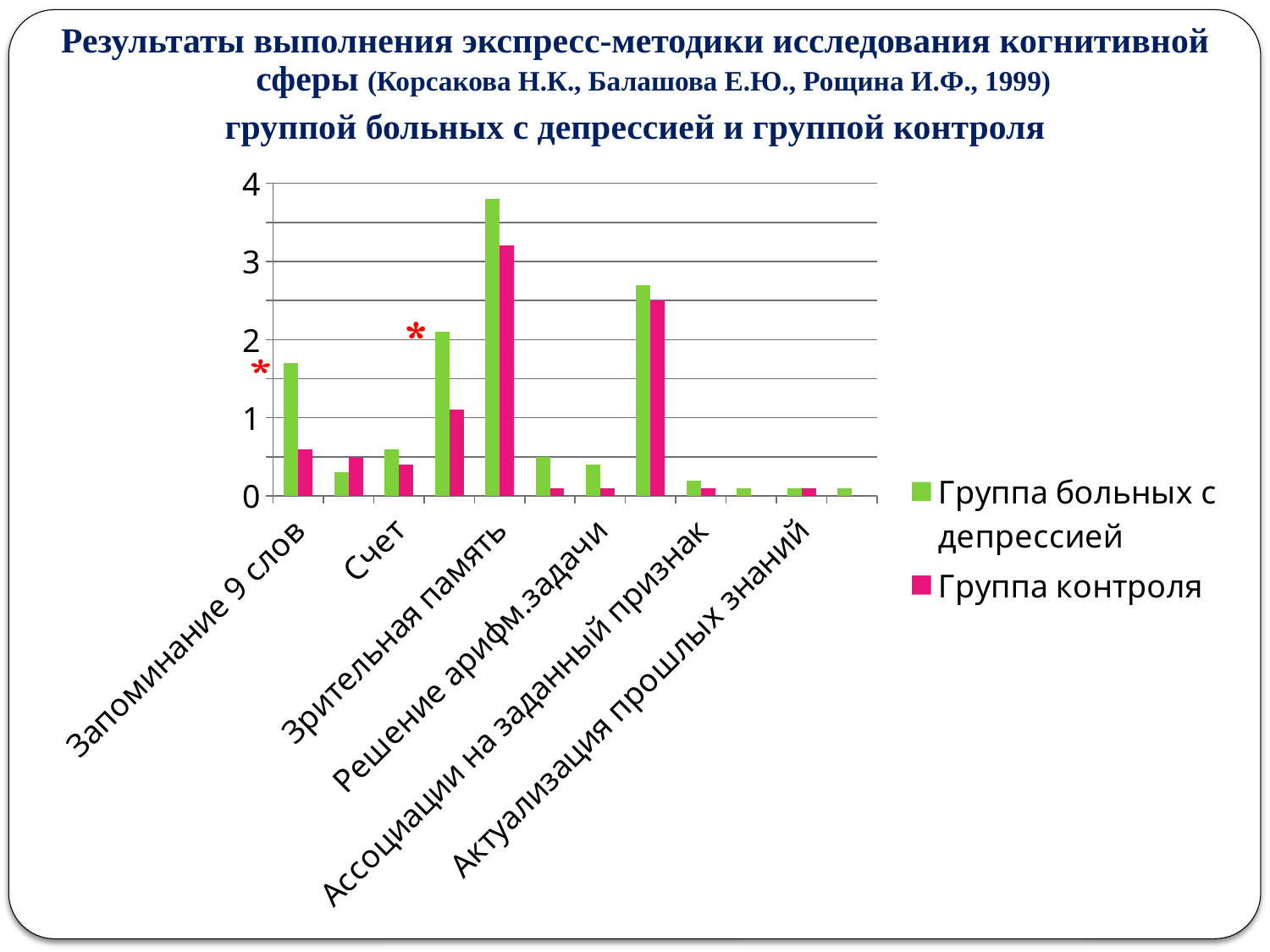
Is the value for Группа контроля on Запоминание 9 слов greater or less than 1? less For Запоминание 9 слов, which group has the larger value: Группа больных с депрессией or Группа контроля? Группа больных с депрессией What kind of chart is shown on the slide? bar chart Is the value for Группа контроля on Решение арифм.задачи greater or less than 1? less Which two series are listed in the legend? Группа больных с депрессией, Группа контроля For Зрительная память, which group has the larger value: Группа больных с депрессией or Группа контроля? Группа больных с депрессией Which colour represents Группа контроля? pink Is the value for Группа больных с депрессией on Запоминание 9 слов greater or less than 1? greater Among the labelled categories, which one has the highest value for Группа больных с депрессией? Зрительная память How many series does the legend list? 2